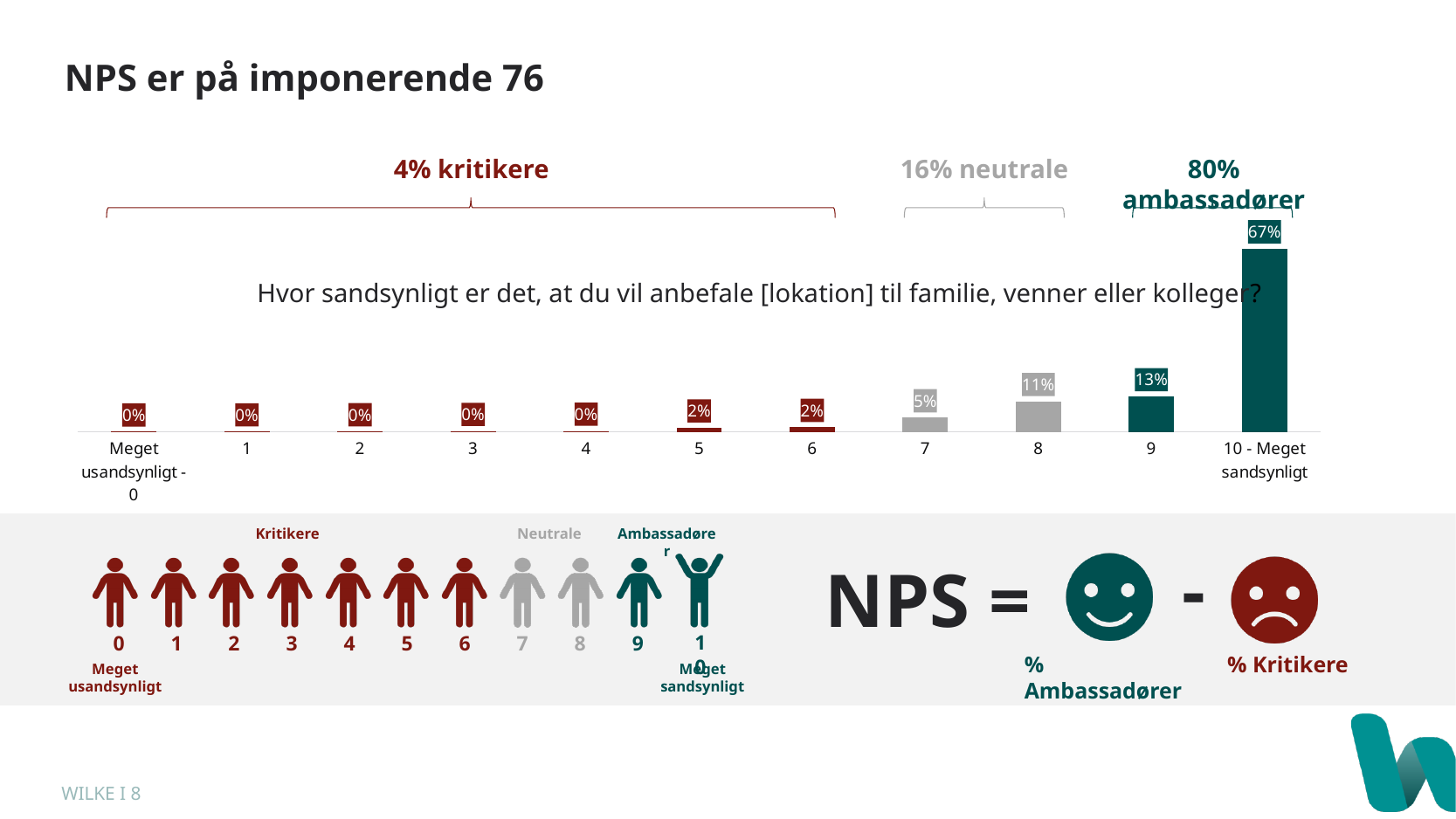
Which has a higher percentage: score 8 or score 7? Score 8 What percentage of respondents gave a score of 9? 13% Do the percentages generally rise or fall as the score increases from 0 to 10? Rise What percentage of respondents gave a score of 8? 11% What percentage of respondents gave a score of 10 - Meget sandsynligt? 67% What is the difference in percentage points between the score 10 bar and the score 9 bar? 54 What percentage of respondents gave a score of 7? 5% What percentage of respondents gave a score of 5? 2% How many score categories are shown on the x axis of the bar chart? 11 What percentage of respondents are labelled as 'ambassadører' above the chart? 80% What type of chart is used to show the distribution of scores? Bar chart Which score category has the highest percentage of respondents? 10 - Meget sandsynligt